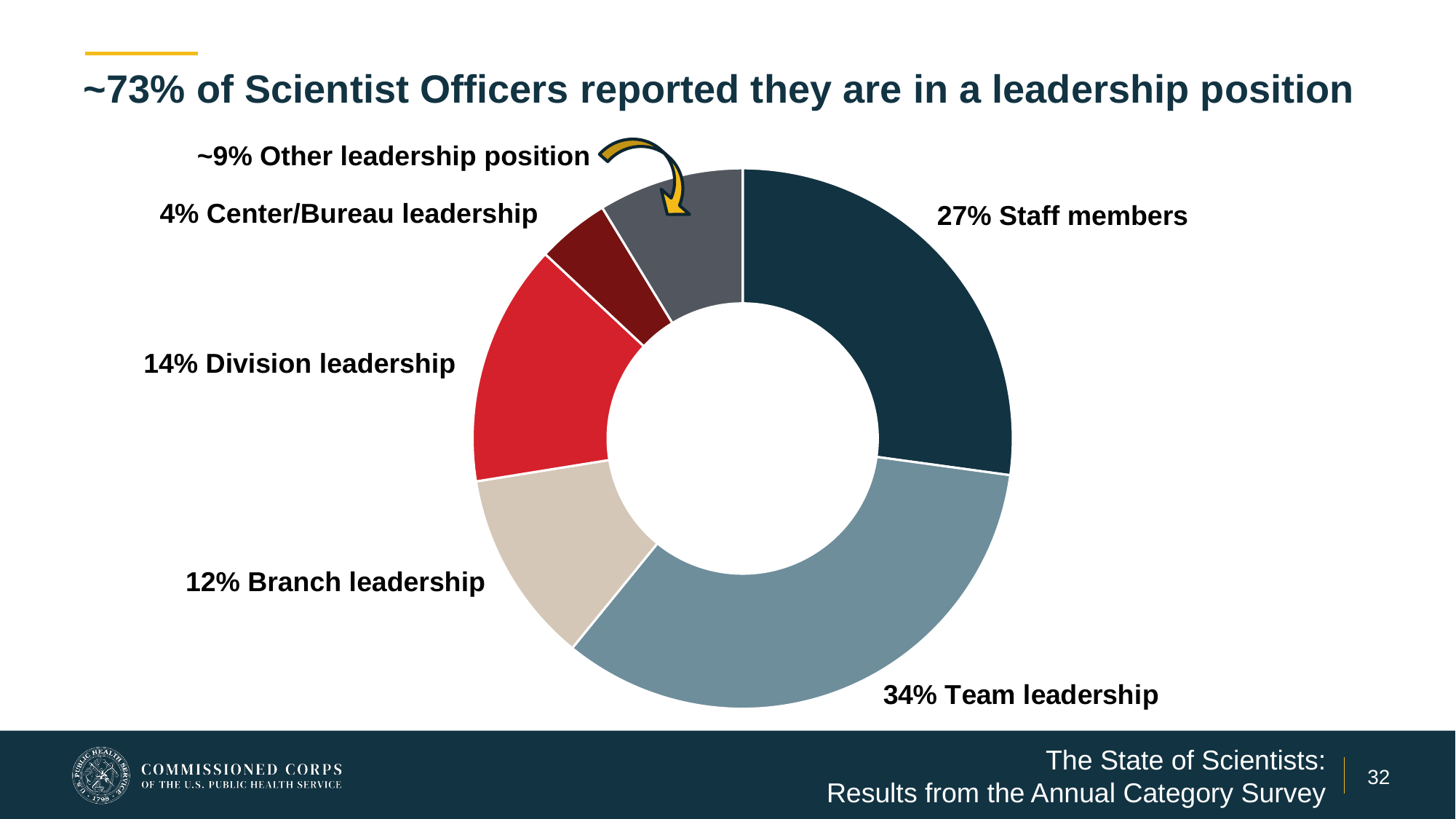
Which is larger, the share for Division leadership or the share for Branch leadership? Division leadership What percentage of Scientist Officers reported being in Team leadership? 34% What percentage of Scientist Officers are Staff members? 27% How many categories are shown in the chart? 6 What percentage is shown for Center/Bureau leadership? 4% What type of chart is shown on the slide? Donut (pie) chart Which category has the largest share of the donut chart? Team leadership Which category has the smallest share of the donut chart? Center/Bureau leadership What percentage is shown for Division leadership? 14% What percentage is shown for Branch leadership? 12% What is the difference in percentage points between Team leadership and Staff members? 7 What is the title of the slide? ~73% of Scientist Officers reported they are in a leadership position